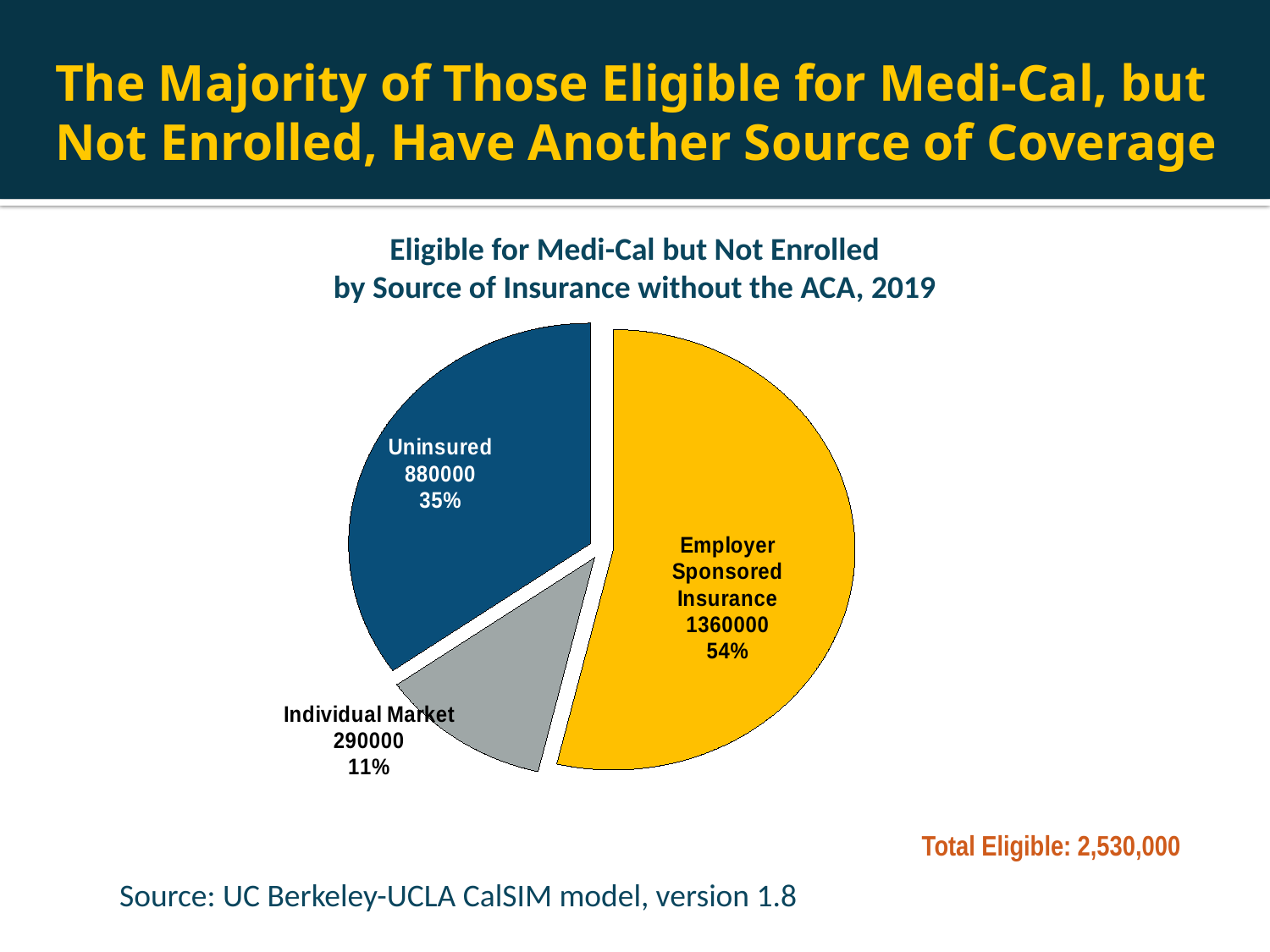
What is the title of the chart? Eligible for Medi-Cal but Not Enrolled by Source of Insurance without the ACA, 2019 What share of the pie is Individual Market? 11% What is the value for Uninsured? 880000 Which category has the largest slice? Employer Sponsored Insurance What is the value for Employer Sponsored Insurance? 1360000 Which category has the smallest slice? Individual Market What share of the pie is Employer Sponsored Insurance? 54% What kind of chart is shown on the slide? Pie chart What is the value for Individual Market? 290000 What is the difference between the values for Employer Sponsored Insurance and Uninsured? 480000 What share of the pie is Uninsured? 35% How many slices does the pie chart have? 3